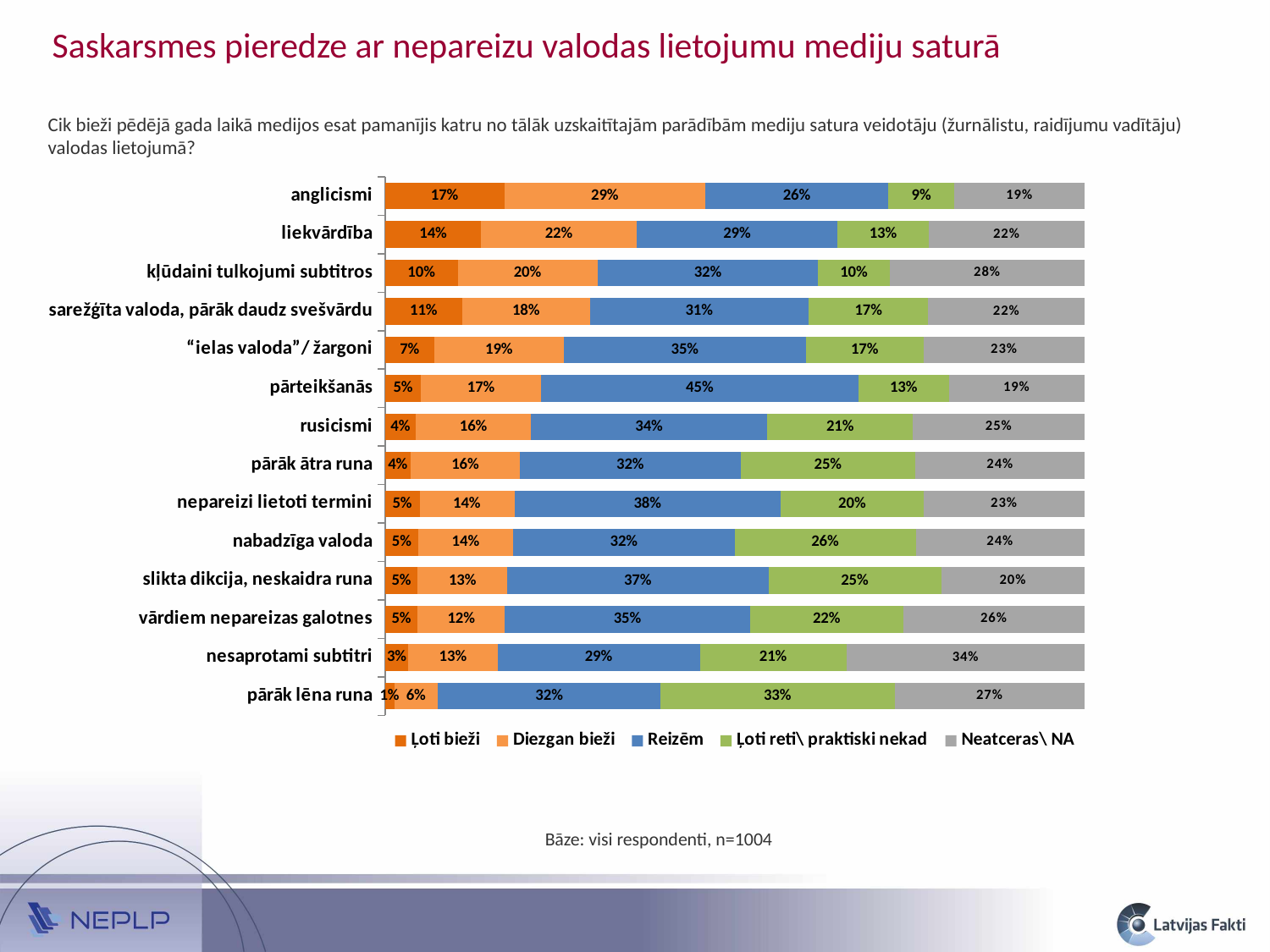
Which category has the highest "Reizēm" value? pārteikšanās Which category has the lowest "Ļoti bieži" value? pārāk lēna runa How many categories are shown on the chart? 14 What percentage of respondents answered "Ļoti bieži" for anglicismi? 17% What is the "Neatceras\ NA" value for nesaprotami subtitri? 34% What is the "Ļoti reti\ praktiski nekad" value for pārāk lēna runa? 33% Which is larger: the "Ļoti reti\ praktiski nekad" value for nabadzīga valoda or for rusicismi? nabadzīga valoda What kind of chart is shown on the slide? Stacked bar chart How many series does the legend list? 5 What is the "Reizēm" value for pārteikšanās? 45% What is the difference in percentage points between the "Diezgan bieži" values for anglicismi and liekvārdība? 7 percentage points Which category has the highest "Ļoti bieži" value? anglicismi